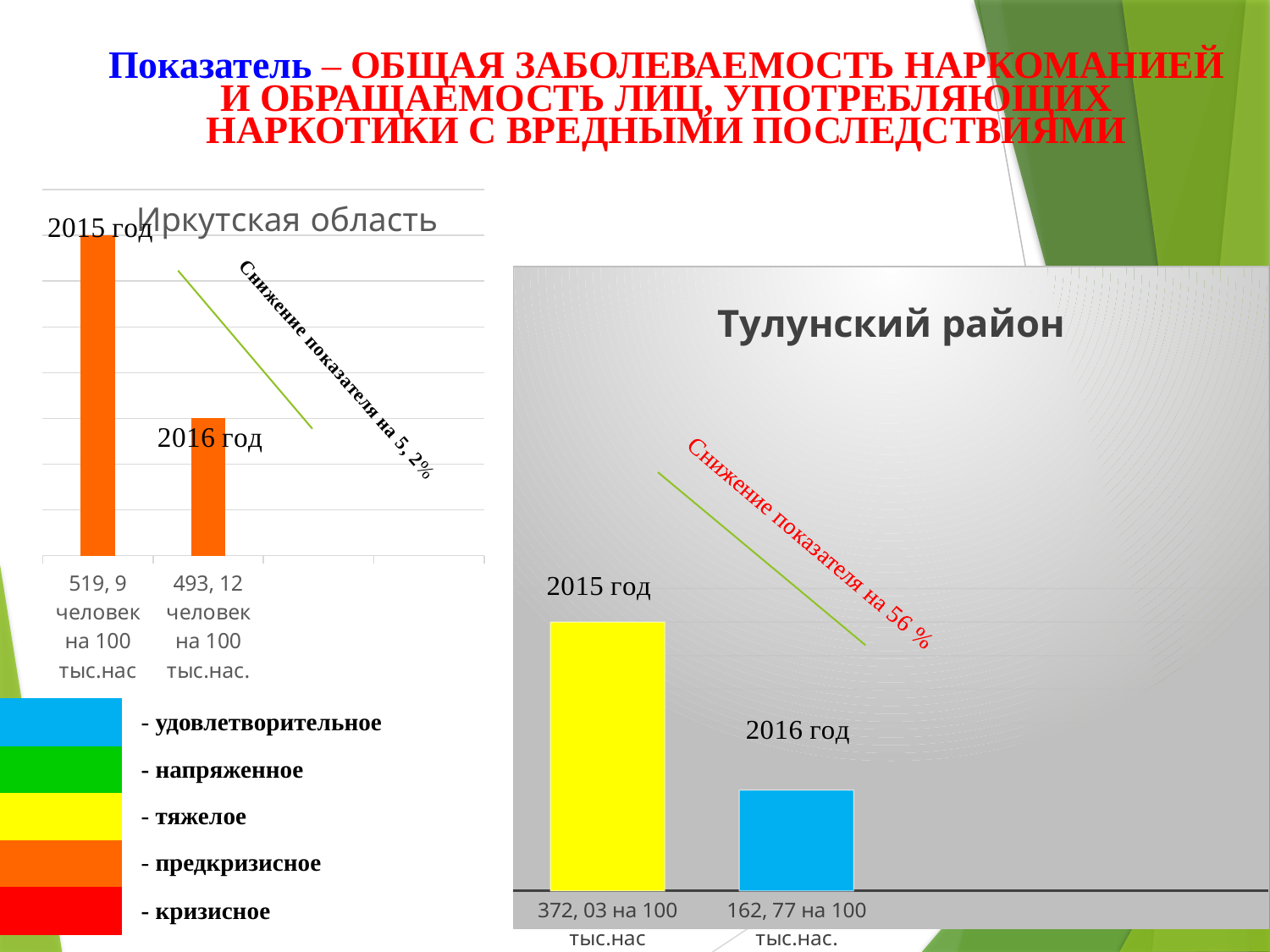
According to the annotation on the 'Иркутская область' chart, by what percentage did the indicator decrease? 5, 2% In the 'Тулунский район' chart, is the value for 2015 год larger or smaller than the value for 2016 год? larger How many bars are shown in the 'Тулунский район' chart? 2 In the 'Иркутская область' chart, do the values rise or fall from 2015 to 2016? fall In the 'Иркутская область' chart, what is the value for 2015 год? 519, 9 человек на 100 тыс.нас In the 'Тулунский район' chart, which year has the lower bar? 2016 год In the 'Тулунский район' chart, what is the value for 2015 год? 372, 03 на 100 тыс.нас In the 'Иркутская область' chart, which year has the higher bar? 2015 год In the 'Иркутская область' chart, what is the value for 2016 год? 493, 12 человек на 100 тыс.нас. In the 'Тулунский район' chart, what is the value for 2016 год? 162, 77 на 100 тыс.нас. What type of chart is the 'Иркутская область' chart? bar chart According to the annotation on the 'Тулунский район' chart, by what percentage did the indicator decrease? 56 %